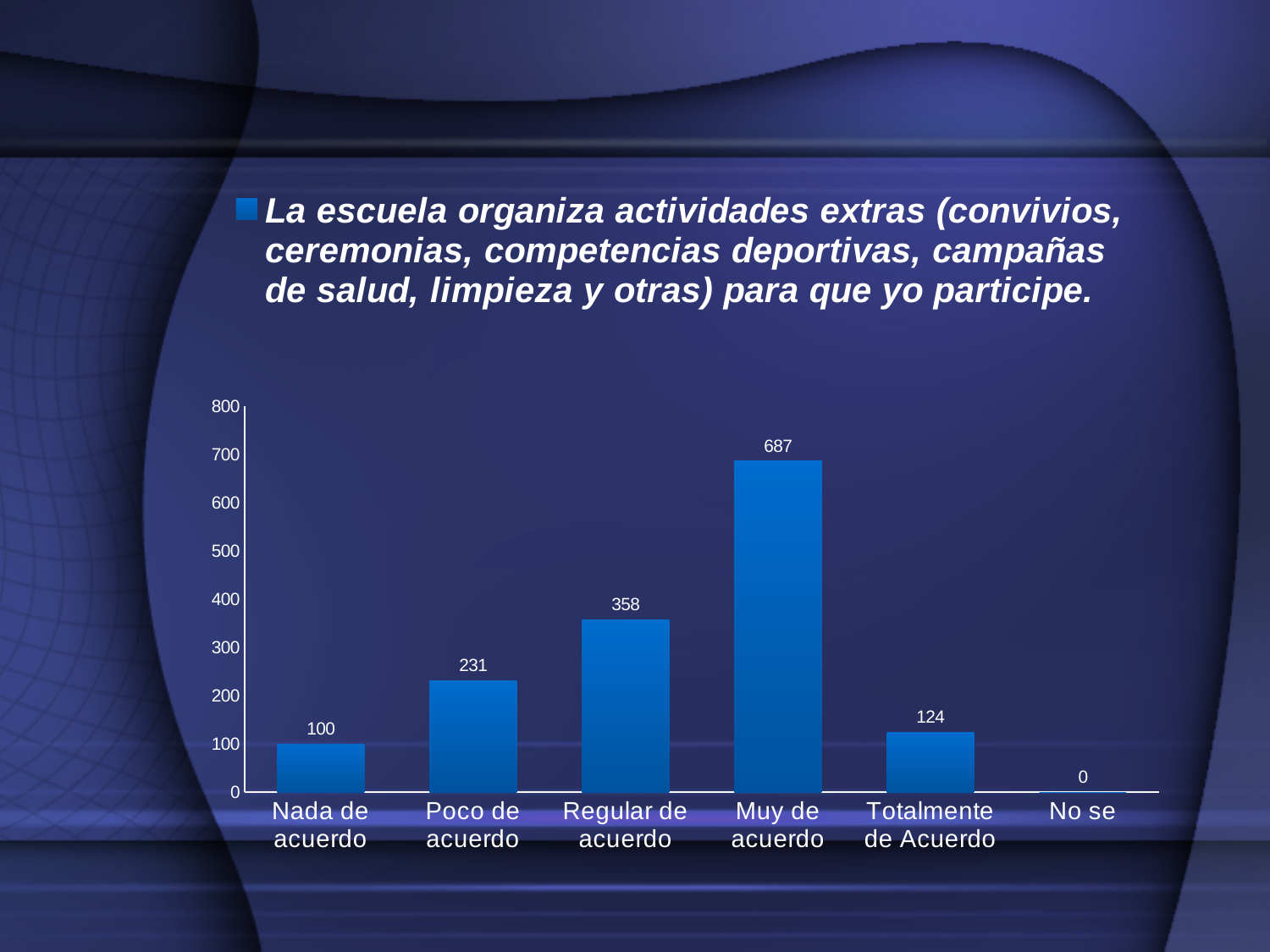
What is the value for "Nada de acuerdo"? 100 How many categories are shown on the x axis? 6 Is the value for "Regular de acuerdo" greater or less than 300? greater What is the value for "Muy de acuerdo"? 687 What is the difference between the values for "Poco de acuerdo" and "Nada de acuerdo"? 131 Which is larger, the value for "Poco de acuerdo" or the value for "Totalmente de Acuerdo"? Poco de acuerdo Which category has the lowest value? No se What is the value for "No se"? 0 What is the value for "Totalmente de Acuerdo"? 124 What kind of chart is shown on the slide? Bar chart Which category has the highest value? Muy de acuerdo What is the difference between the values for "Muy de acuerdo" and "Regular de acuerdo"? 329